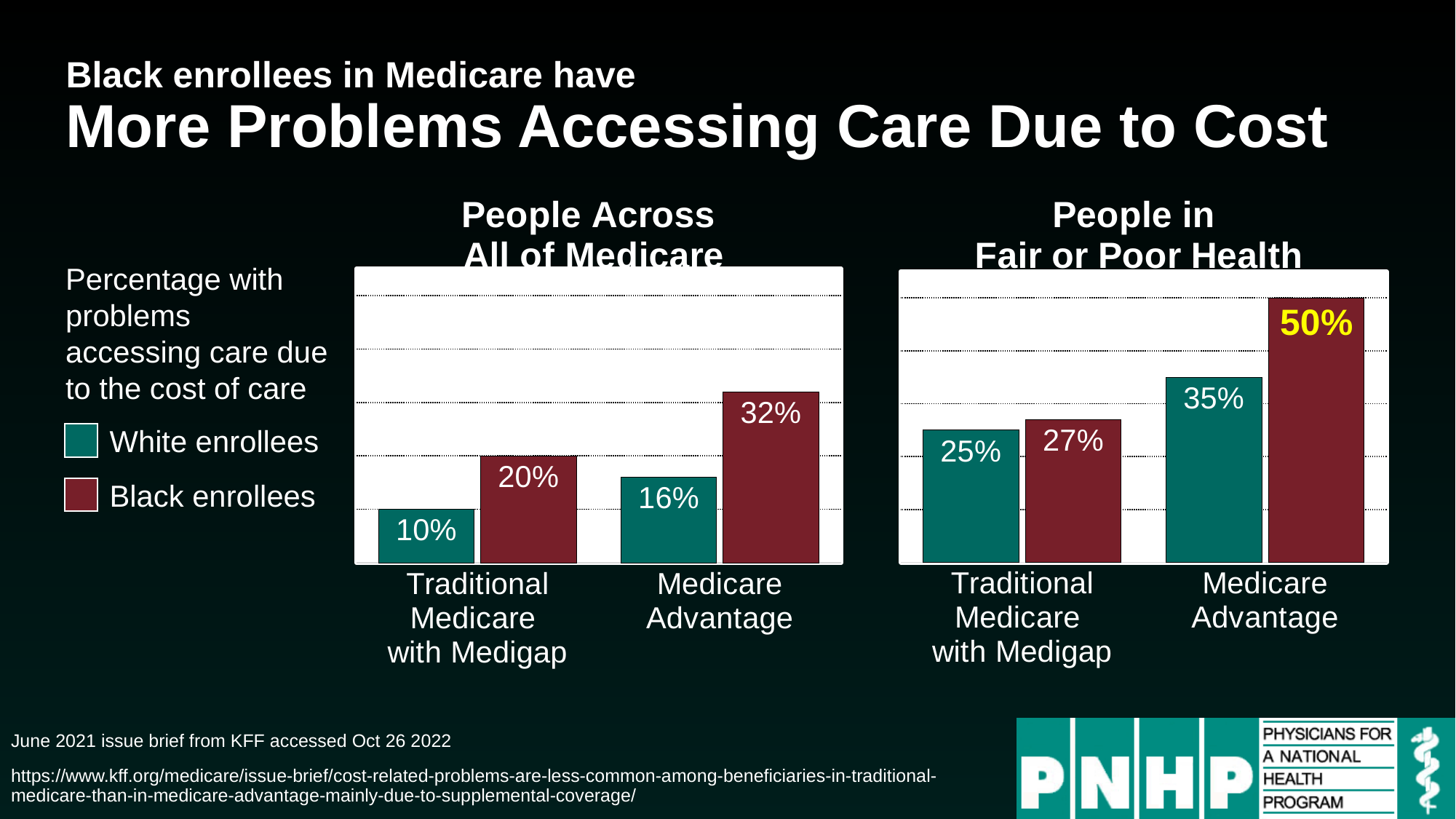
In the 'People in Fair or Poor Health' chart, which is larger: White enrollees in Medicare Advantage or Black enrollees in Traditional Medicare with Medigap? White enrollees in Medicare Advantage In the 'People Across All of Medicare' chart, what is the value for Black enrollees in Medicare Advantage? 32% How many series does the legend list? 2 In the 'People in Fair or Poor Health' chart, what is the value for Black enrollees in Medicare Advantage? 50% In the 'People in Fair or Poor Health' chart, which bar has the highest value? Black enrollees, Medicare Advantage In the 'People Across All of Medicare' chart, which bar has the lowest value? White enrollees, Traditional Medicare with Medigap In the 'People Across All of Medicare' chart, what is the value for White enrollees in Traditional Medicare with Medigap? 10% In the 'People in Fair or Poor Health' chart, what is the value for White enrollees in Traditional Medicare with Medigap? 25% What colour represents Black enrollees in the legend? Dark red In the 'People in Fair or Poor Health' chart, what is the difference between Black and White enrollees in Traditional Medicare with Medigap? 2% In the 'People Across All of Medicare' chart, what is the difference between Black and White enrollees in Medicare Advantage? 16% What kind of chart is the 'People Across All of Medicare' chart? Bar chart